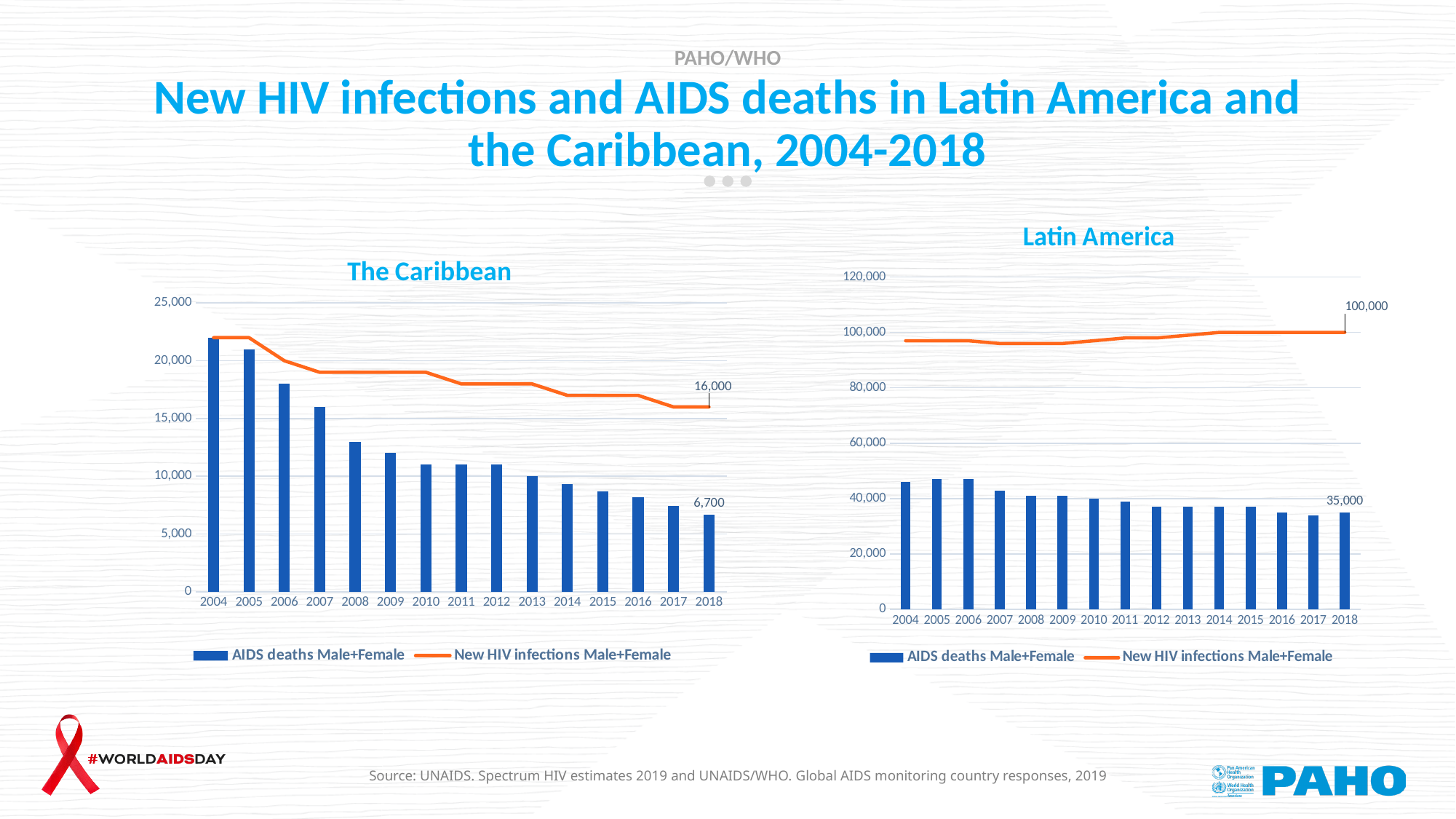
In the Caribbean chart, what is the value of AIDS deaths Male+Female in 2018? 6,700 In the Latin America chart, what is the value of New HIV infections Male+Female in 2018? 100,000 In the Latin America chart, is the value for AIDS deaths Male+Female in 2004 greater or less than 40,000? greater In the Caribbean chart, what is the value of New HIV infections Male+Female in 2018? 16,000 How many years are shown on the x axis of the Latin America chart? 15 How many series does the legend of the Caribbean chart list? 2 In the Caribbean chart, how do AIDS deaths Male+Female change from 2004 to 2018? They fall In the Latin America chart, which series is shown as an orange line? New HIV infections Male+Female In the Latin America chart, what is the value of AIDS deaths Male+Female in 2018? 35,000 In the Caribbean chart, which year has the lowest value for AIDS deaths Male+Female? 2018 In the Caribbean chart, which year has the highest value for AIDS deaths Male+Female? 2004 In the Caribbean chart, is the value for AIDS deaths Male+Female in 2004 greater or less than 20,000? greater